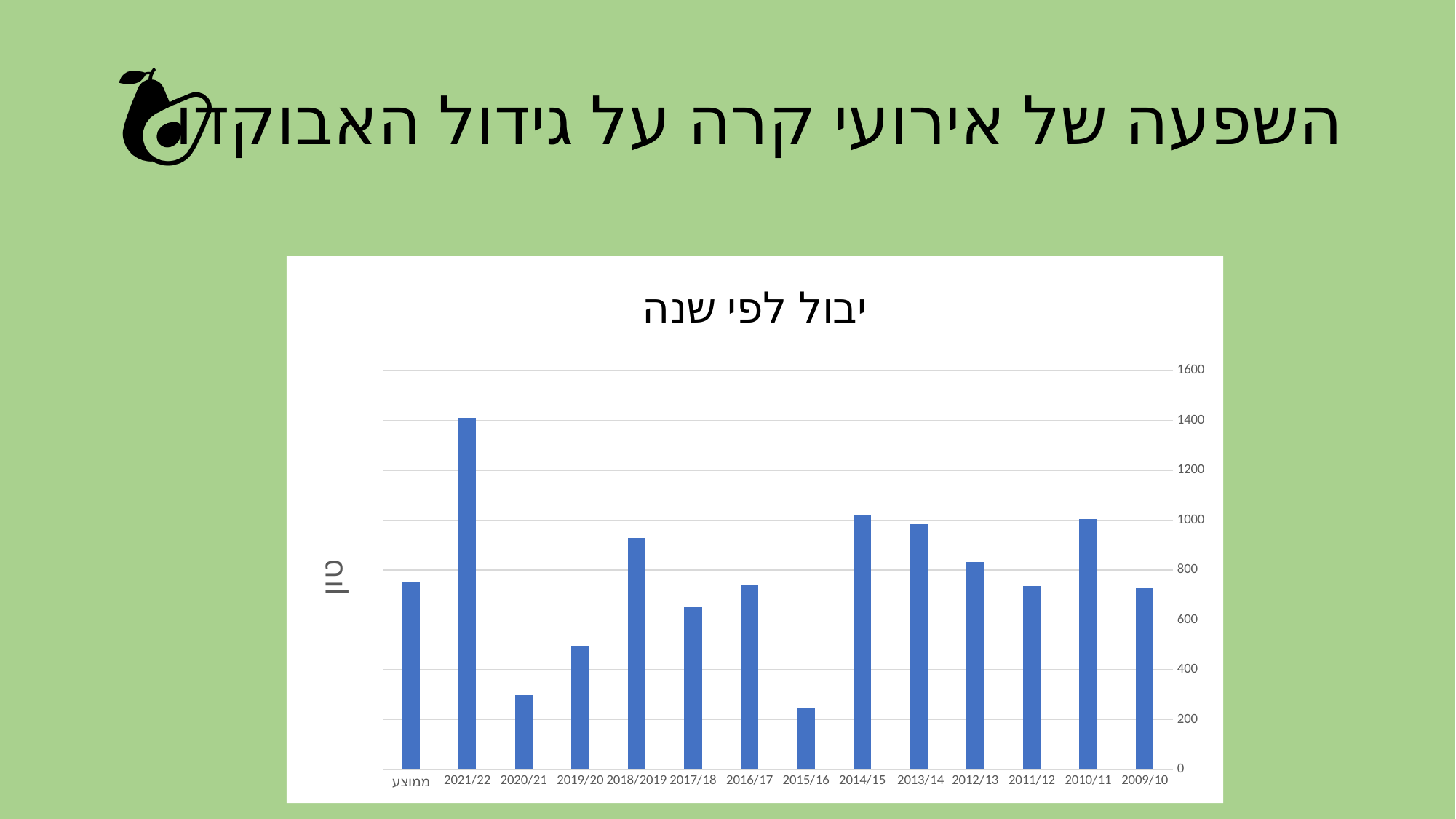
Which is larger, the value for 2014/15 or the value for 2015/16? 2014/15 What is the label on the vertical axis of the chart? טון Which category has the lowest bar in the chart? 2015/16 Is the value for 2019/20 greater or less than 600? less What is the title of the chart? יבול לפי שנה Which is larger, the value for 2018/2019 or the value for 2017/18? 2018/2019 Which category has the highest bar in the chart? 2021/22 Is the value for 2021/22 greater or less than 1200? greater Is the value for 2020/21 greater or less than 400? less How many bars are plotted in the chart? 14 What kind of chart is shown on the slide? bar chart